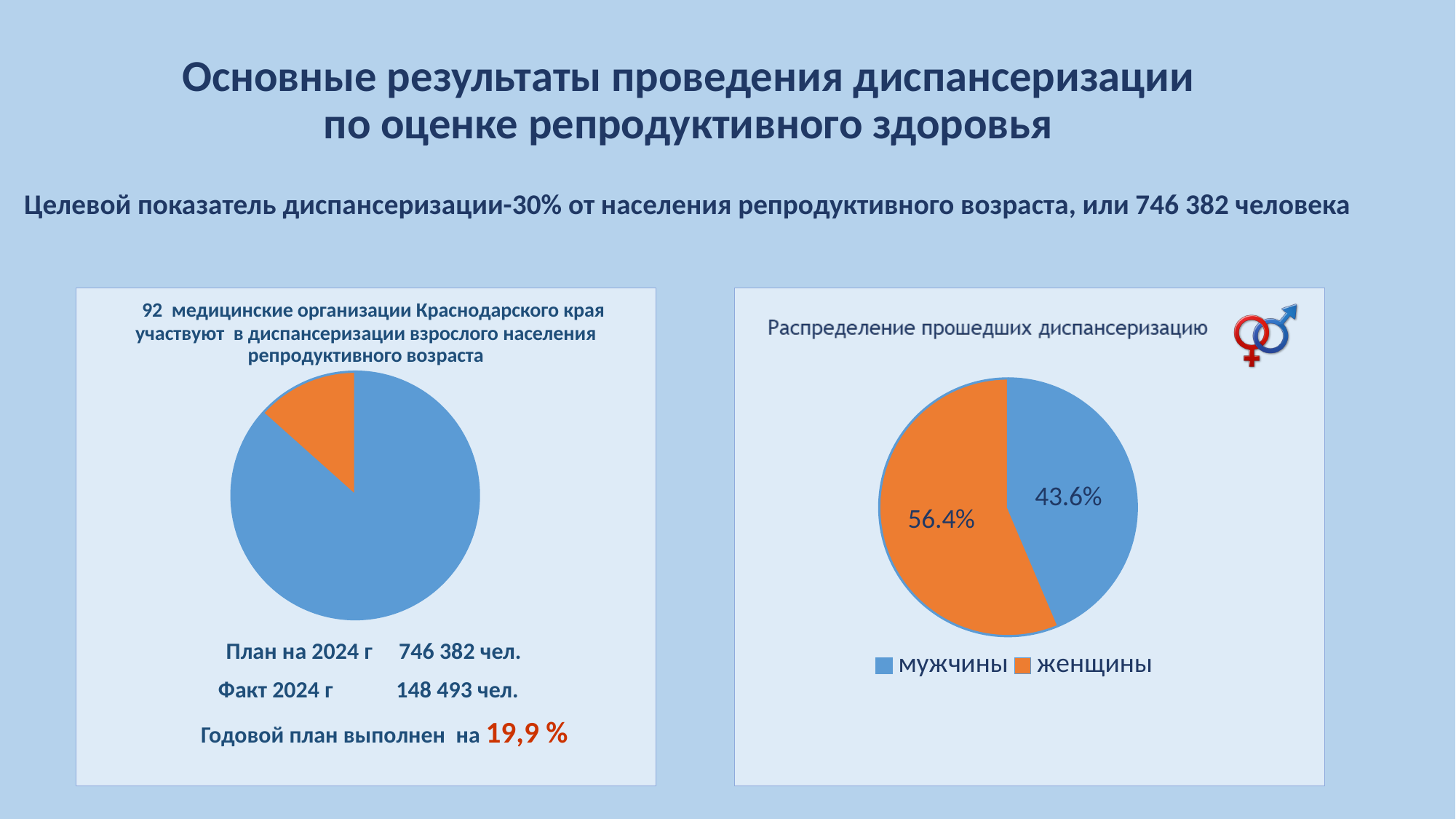
In the left panel, what is the value given for 'План на 2024 г'? 746 382 чел. What kind of chart is the chart titled 'Распределение прошедших диспансеризацию'? pie chart In the chart 'Распределение прошедших диспансеризацию', what colour is the slice for женщины? orange What kind of chart is shown in the left panel about the 92 medical organisations of Krasnodar Krai? pie chart How many slices does the pie chart in the left panel have? 2 In the chart 'Распределение прошедших диспансеризацию', what share is shown for мужчины? 43.6% How many entries does the legend of the chart 'Распределение прошедших диспансеризацию' list? 2 In the chart 'Распределение прошедших диспансеризацию', which group has the smaller share? мужчины In the chart 'Распределение прошедших диспансеризацию', by how many percentage points does the share of женщины exceed the share of мужчины? 12.8 In the left panel, what is the value given for 'Факт 2024 г'? 148 493 чел. In the chart 'Распределение прошедших диспансеризацию', what share is shown for женщины? 56.4% In the chart 'Распределение прошедших диспансеризацию', which group has the larger share? женщины